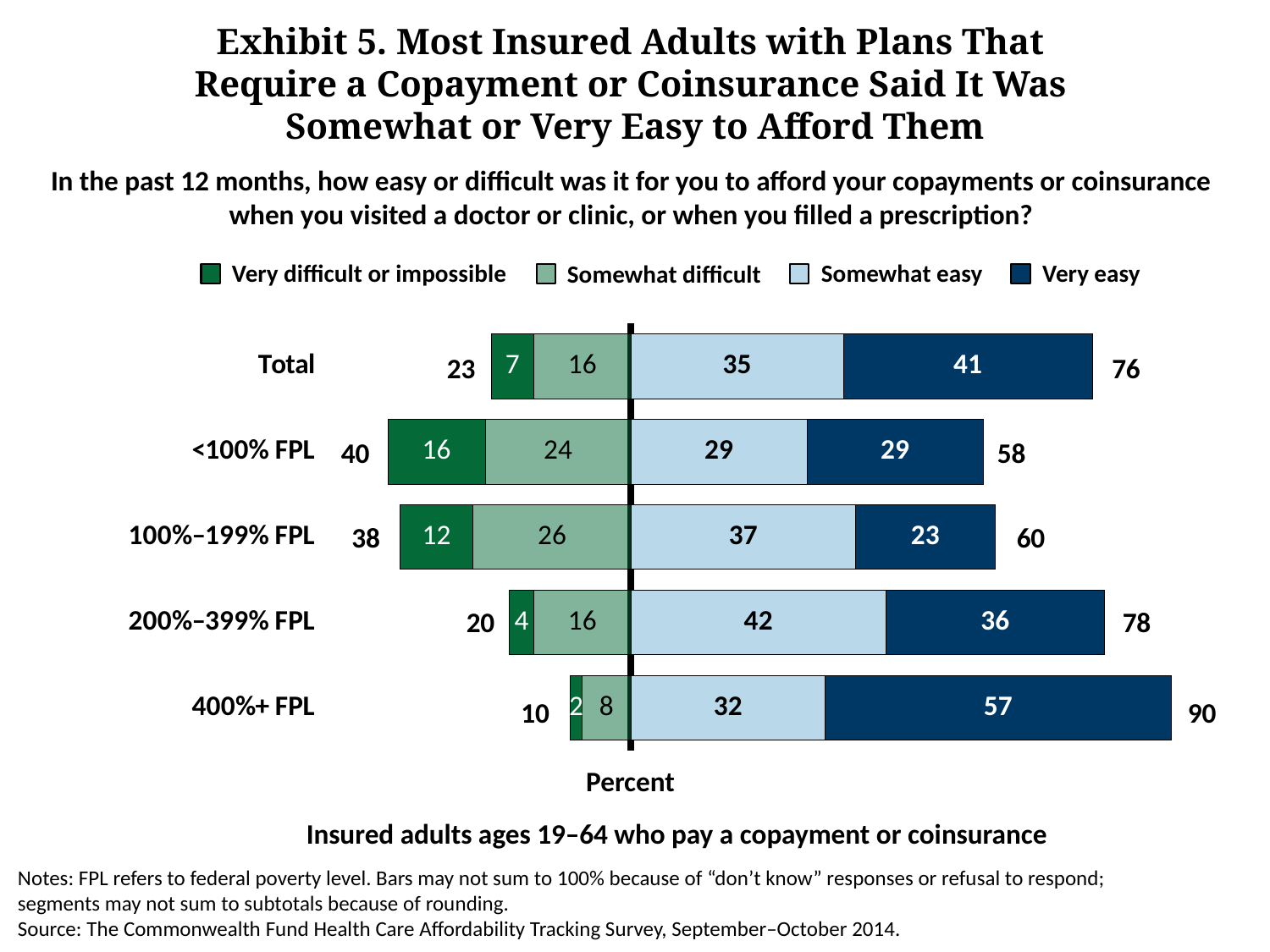
What is the difference between the 'Very easy' values for the 400%+ FPL group and the 100%–199% FPL group? 34 What is the combined 'somewhat difficult or very difficult' subtotal shown for the 200%–399% FPL group? 20 Which is larger: the 'Somewhat easy' value for the Total bar or the 'Somewhat easy' value for the 100%–199% FPL group? 100%–199% FPL What label is shown on the horizontal axis of the chart? Percent What percentage of adults with incomes of 400%+ FPL said it was very easy to afford their copayments or coinsurance? 57 What type of chart is shown on the slide? Stacked bar chart How many income categories (including Total) are shown in the chart? 5 Which income group has the highest 'Very difficult or impossible' value? <100% FPL What is the 'Somewhat difficult' value for the <100% FPL group? 24 How many response categories does the legend list? 4 What is the 'Somewhat easy' value for the 200%–399% FPL group? 42 Which income group has the lowest combined 'somewhat easy or very easy' subtotal? <100% FPL